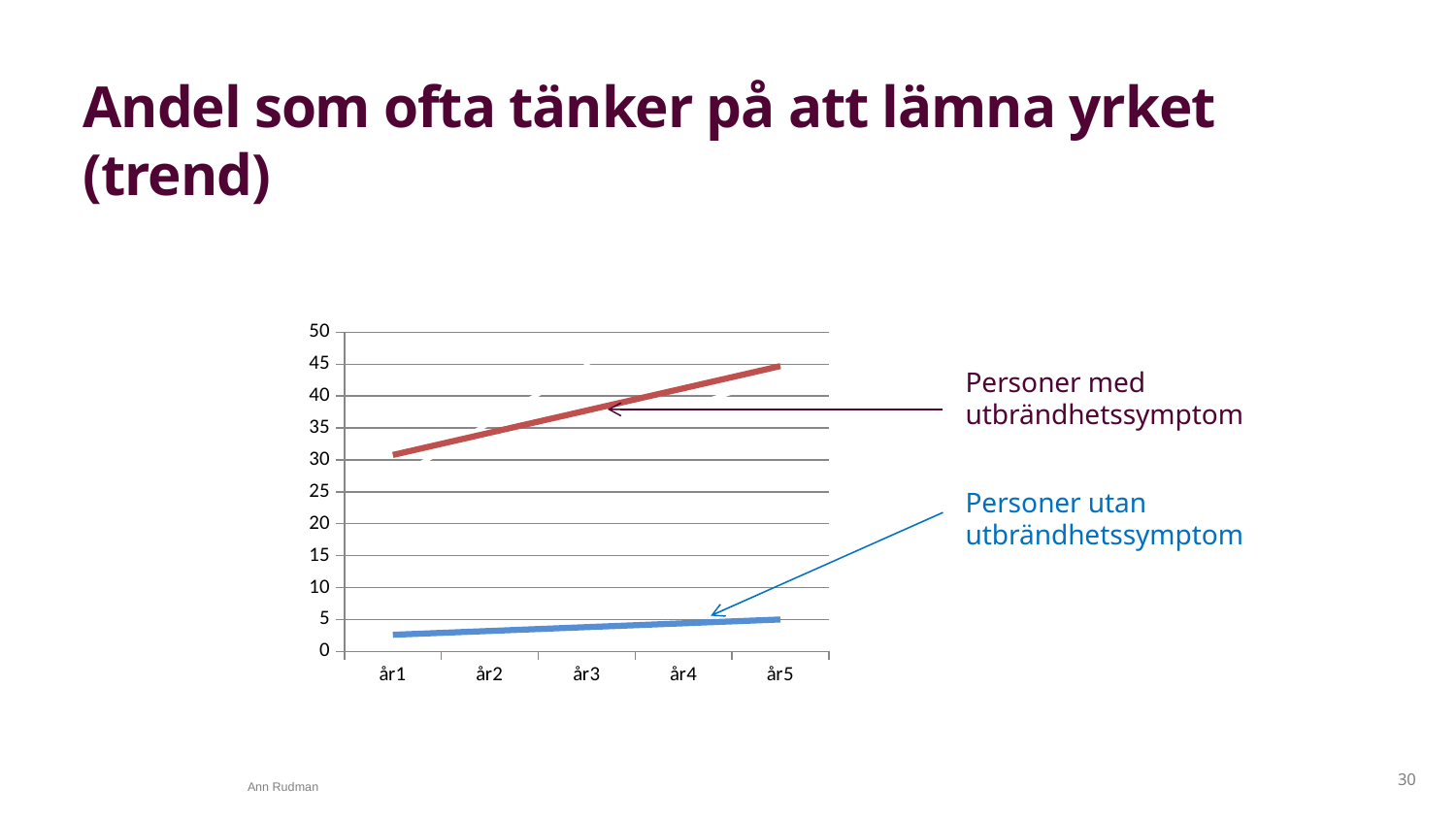
Is the value for 'Personer med utbrändhetssymptom' at år1 greater or less than 35? less How many years (points) are shown on the x axis? 5 What colour is the line for 'Personer utan utbrändhetssymptom'? blue Does the line for 'Personer med utbrändhetssymptom' rise or fall from år1 to år5? rise What kind of chart is shown on the slide? line chart In which year is the value for 'Personer med utbrändhetssymptom' highest? år5 Is the value for 'Personer med utbrändhetssymptom' at år5 greater or less than 40? greater In which year is the value for 'Personer utan utbrändhetssymptom' lowest? år1 Which series has the higher value at år5, 'Personer med utbrändhetssymptom' or 'Personer utan utbrändhetssymptom'? Personer med utbrändhetssymptom Does the line for 'Personer utan utbrändhetssymptom' rise or fall from år1 to år5? rise Is the value for 'Personer utan utbrändhetssymptom' at år5 greater or less than 10? less How many series are plotted in the chart? 2